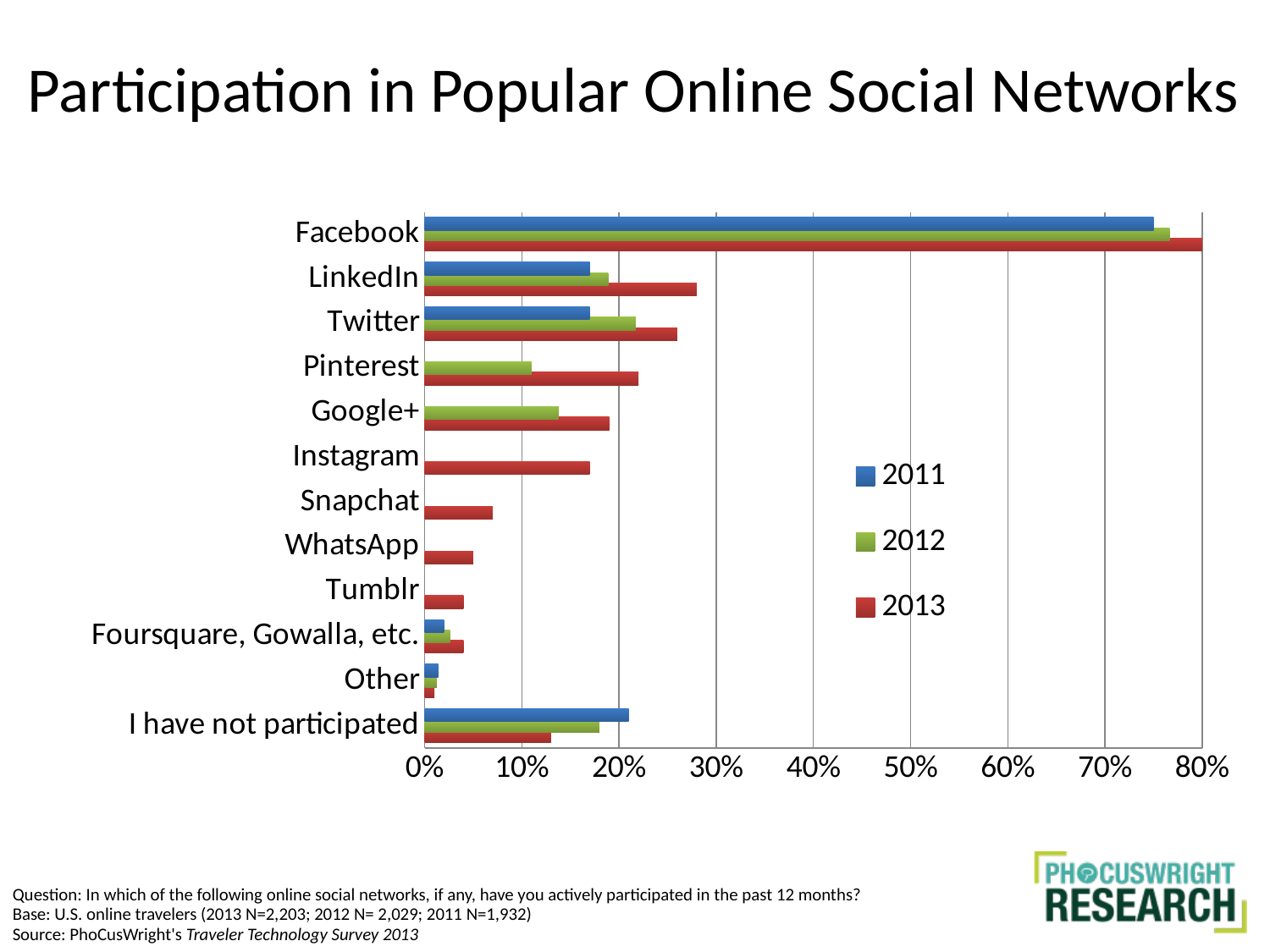
How many social network categories are listed on the vertical axis? 12 Which colour represents the 2013 series in the legend? red Is the 2012 value for Pinterest greater or less than 20%? less Which category has the lowest 2013 value? Other Is the 2013 value for Snapchat greater or less than 10%? less Is the 2011 value for Facebook greater or less than 70%? greater What kind of chart is shown on the slide? bar chart For 'I have not participated', do the values rise or fall from 2011 to 2013? fall For Facebook, which is larger: the 2011 value or the 2013 value? 2013 How many series does the legend list? 3 Which category has the highest 2013 value? Facebook